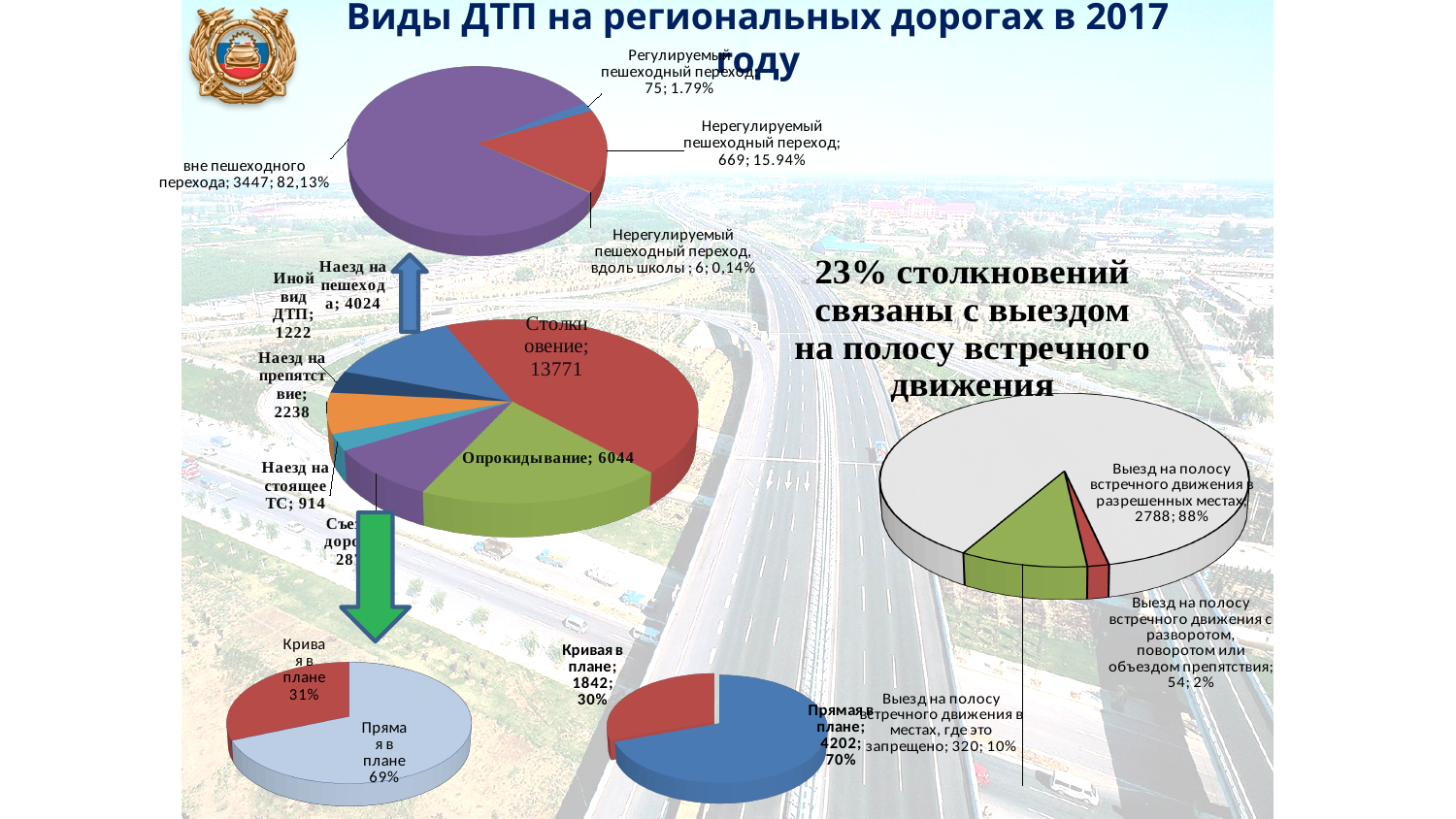
In the middle-left pie chart of accident types, which category has the largest value? Столкновение In the middle-left pie chart of accident types, what value is shown for 'Столкновение'? 13771 In the right pie chart on driving into the oncoming lane, what share is shown for 'в местах, где это запрещено'? 10% In the middle-left pie chart of accident types, what value is shown for 'Опрокидывание'? 6044 In the right pie chart on driving into the oncoming lane, what value is shown for 'в разрешенных местах'? 2788; 88% What kind of chart is the bottom-left chart showing 'Кривая в плане' and 'Прямая в плане'? Pie chart In the top-left pie chart on pedestrian crossings, what share is shown for 'Регулируемый пешеходный переход'? 1.79% In the bottom-middle pie chart, what value is shown for 'Прямая в плане'? 4202; 70% In the top-left pie chart on pedestrian crossings, which category has the smallest value? Нерегулируемый пешеходный переход, вдоль школы In the top-left pie chart on pedestrian crossings, what value is shown for 'вне пешеходного перехода'? 3447; 82,13% In the middle-left pie chart of accident types, what is the difference between 'Столкновение' and 'Опрокидывание'? 7727 In the middle-left pie chart of accident types, which is larger: 'Наезд на препятствие' or 'Иной вид ДТП'? Наезд на препятствие